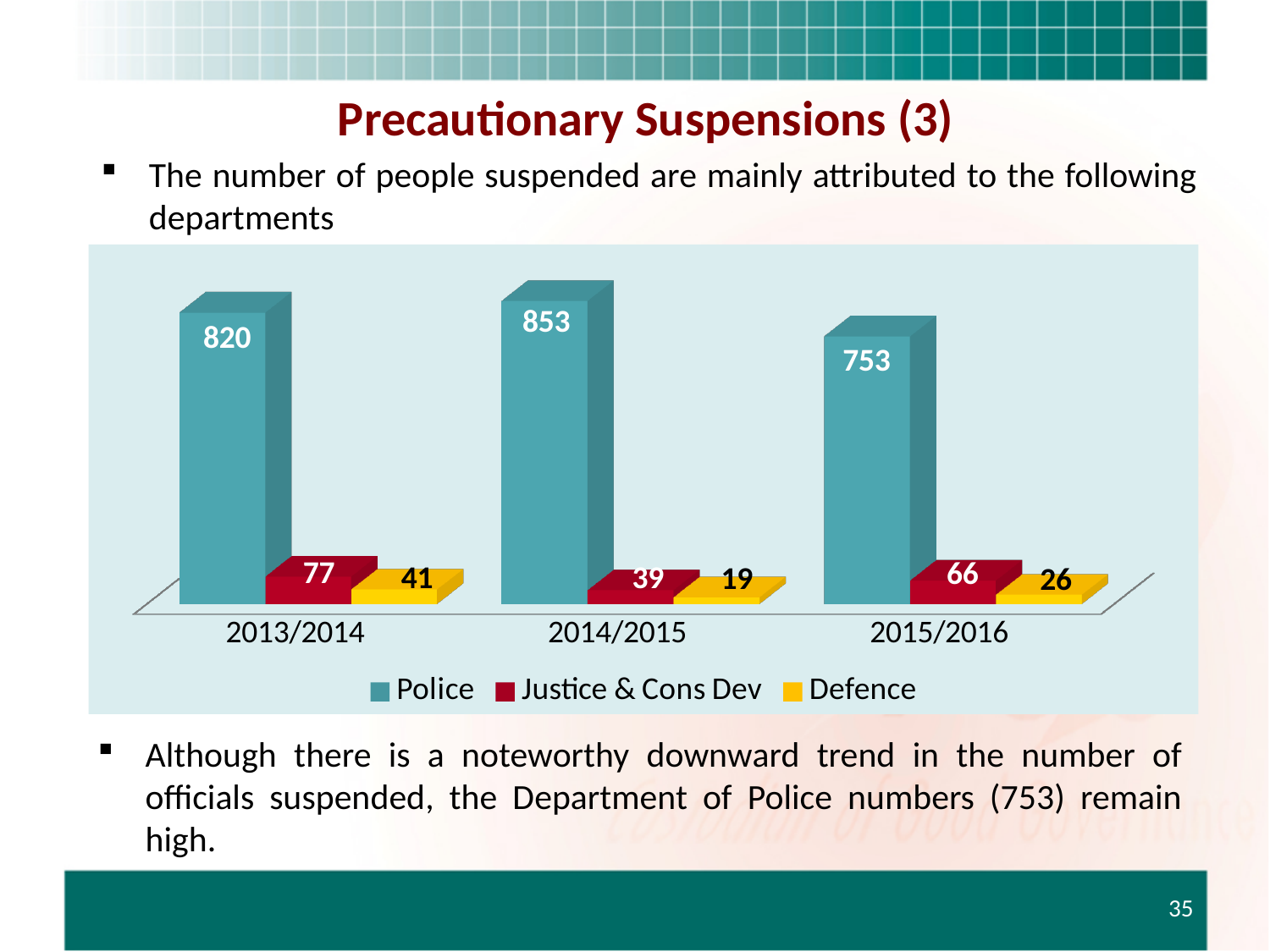
What is the value for Defence in 2015/2016? 26 What is the difference between the Police values for 2014/2015 and 2015/2016? 100 How many series does the legend list? 3 What is the value for Justice & Cons Dev in 2013/2014? 77 In which year is the Defence value lowest? 2014/2015 What kind of chart is shown on the slide? Bar chart What is the value for Police in 2014/2015? 853 Which series is shown in yellow in the legend? Defence Which is larger, the Justice & Cons Dev value in 2013/2014 or in 2015/2016? 2013/2014 How many year categories are shown on the x axis? 3 In which year is the Police value highest? 2014/2015 Does the Police value rise or fall from 2014/2015 to 2015/2016? Fall